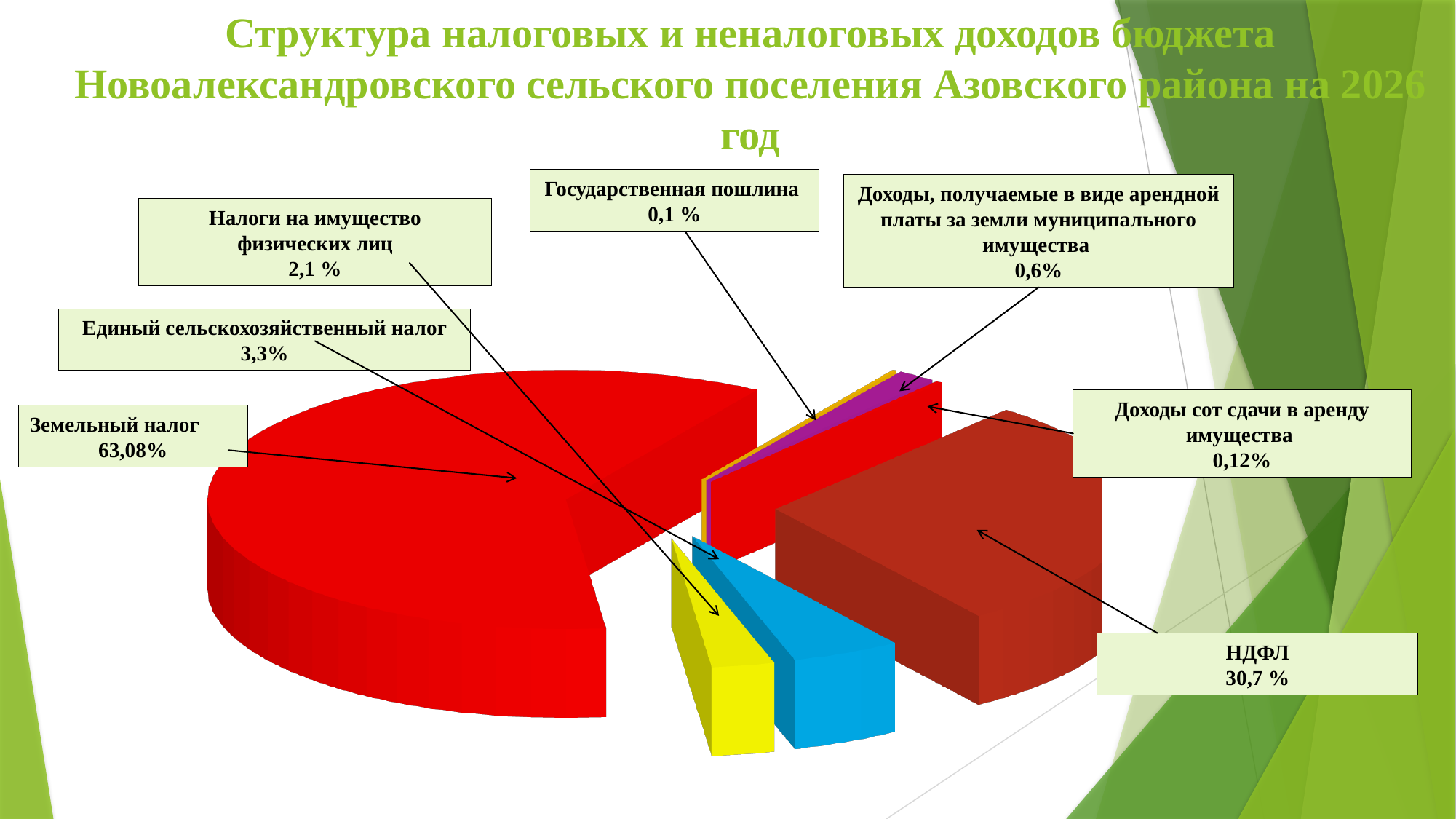
What share is shown for Государственная пошлина? 0,1 % How many categories are shown in the pie chart? 7 What share is shown for Единый сельскохозяйственный налог? 3,3% Which is larger: the share for НДФЛ or the share for Единый сельскохозяйственный налог? НДФЛ What kind of chart is shown on the slide? Pie chart Which category has the smallest share of the pie? Государственная пошлина What colour is the slice for Земельный налог? Red What share is shown for Доходы сот сдачи в аренду имущества? 0,12% What share is shown for Налоги на имущество физических лиц? 2,1 % What share of the budget revenue is Земельный налог? 63,08% What share is shown for НДФЛ? 30,7 % Which category has the largest share of the pie? Земельный налог